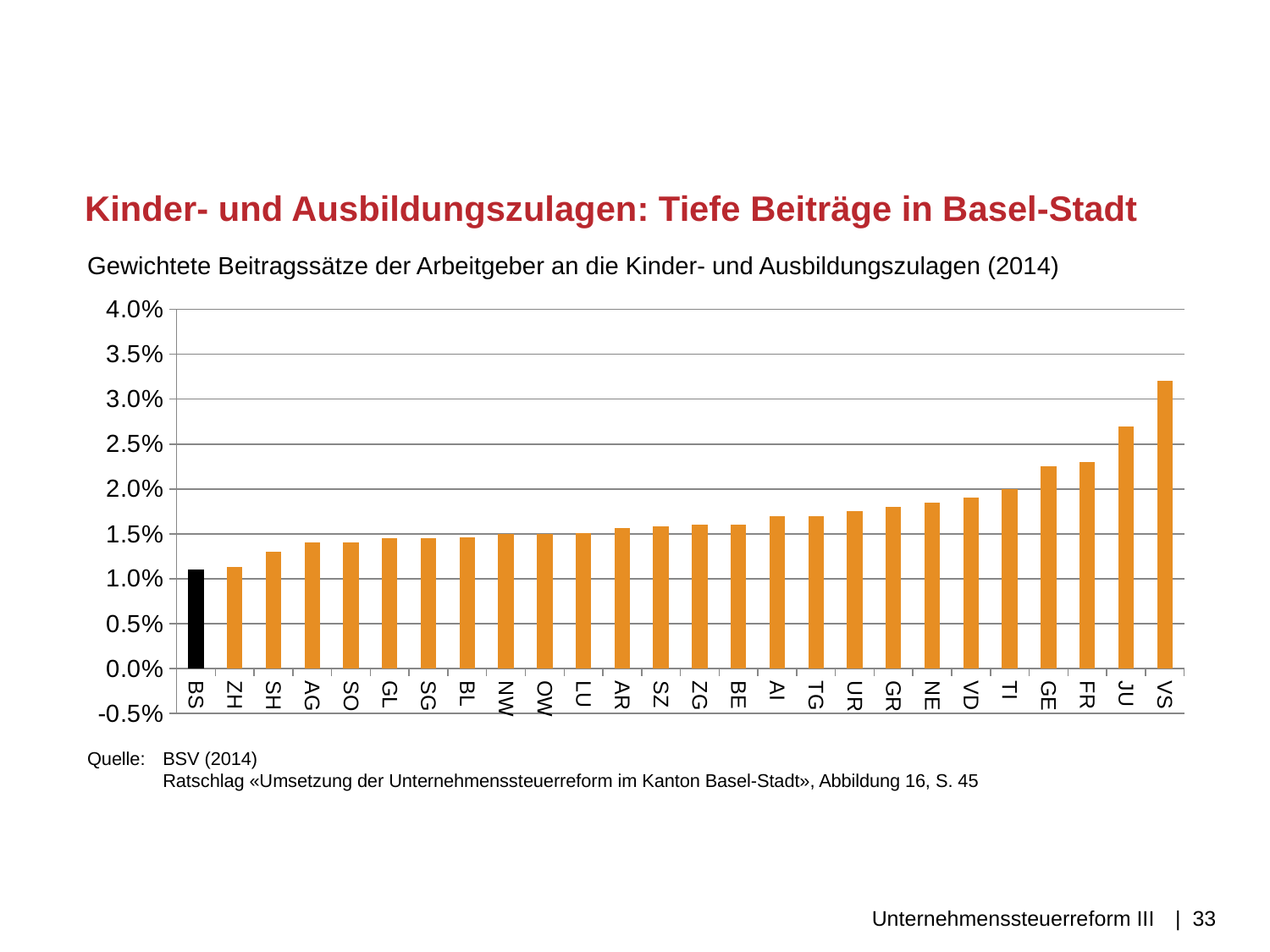
Do the bar values generally rise or fall from left to right along the x axis? rise Which canton has the lowest employer contribution rate in the chart? BS Which canton has the larger value, JU or GE? JU Is the value for BS greater or less than 1.5%? less How many cantons are shown on the x axis of the chart? 26 Which canton has the highest employer contribution rate in the chart? VS Is the value for GE greater or less than 2.0%? greater Is the value for JU greater or less than 2.5%? greater Which canton's bar is coloured black instead of orange? BS What kind of chart is shown on the slide? bar chart